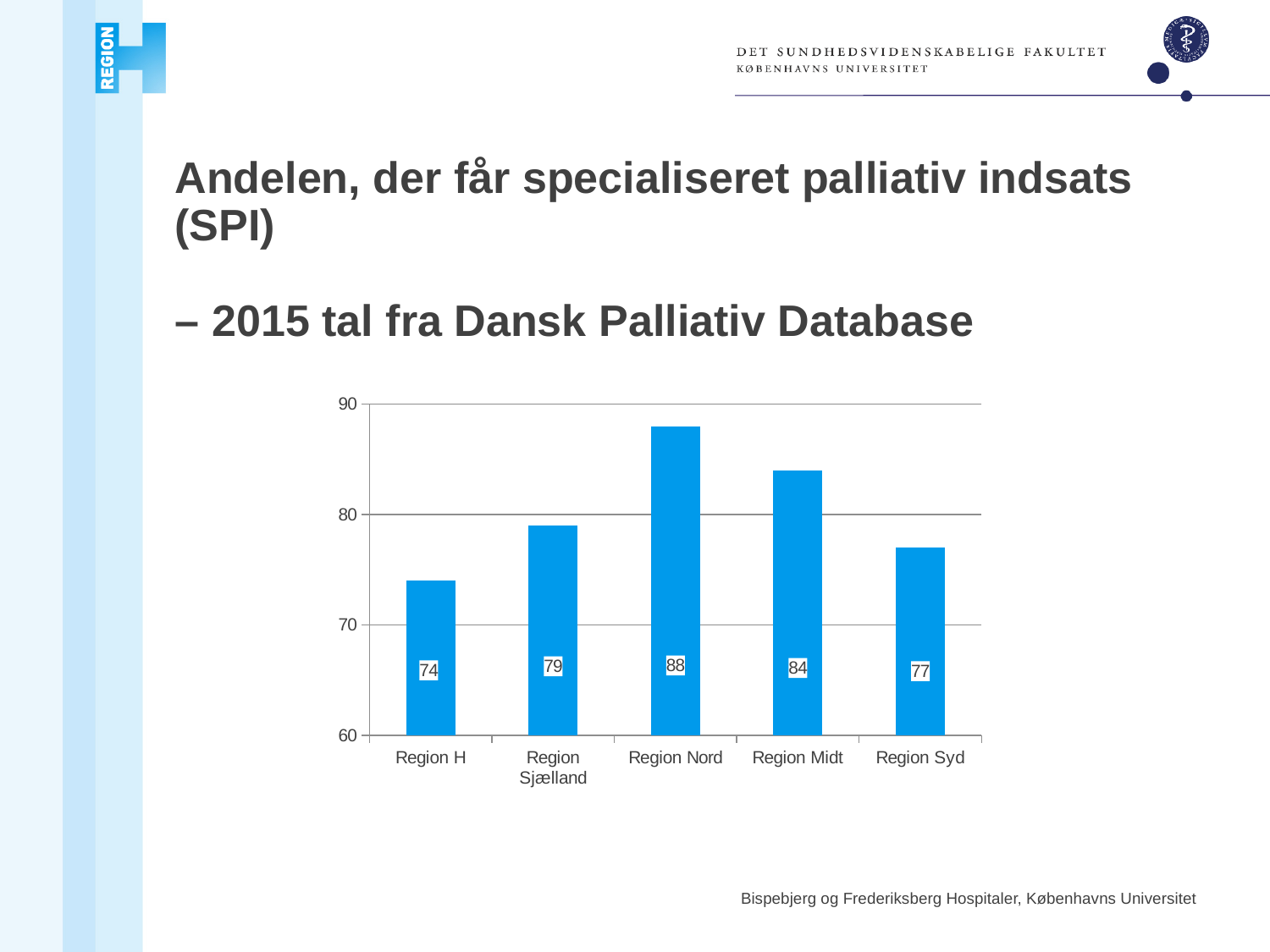
Which region has the lowest value? Region H Is the value for Region Midt greater or less than 80? greater What kind of chart is shown on the slide? Bar chart What is the value for Region H? 74 Which is larger, the value for Region Sjælland or the value for Region Syd? Region Sjælland What is the difference between the values for Region Nord and Region H? 14 How many regions are shown on the chart? 5 What is the value for Region Sjælland? 79 Which region has the highest value? Region Nord What is the value for Region Nord? 88 What is the difference between the values for Region Midt and Region Syd? 7 What is the value for Region Syd? 77